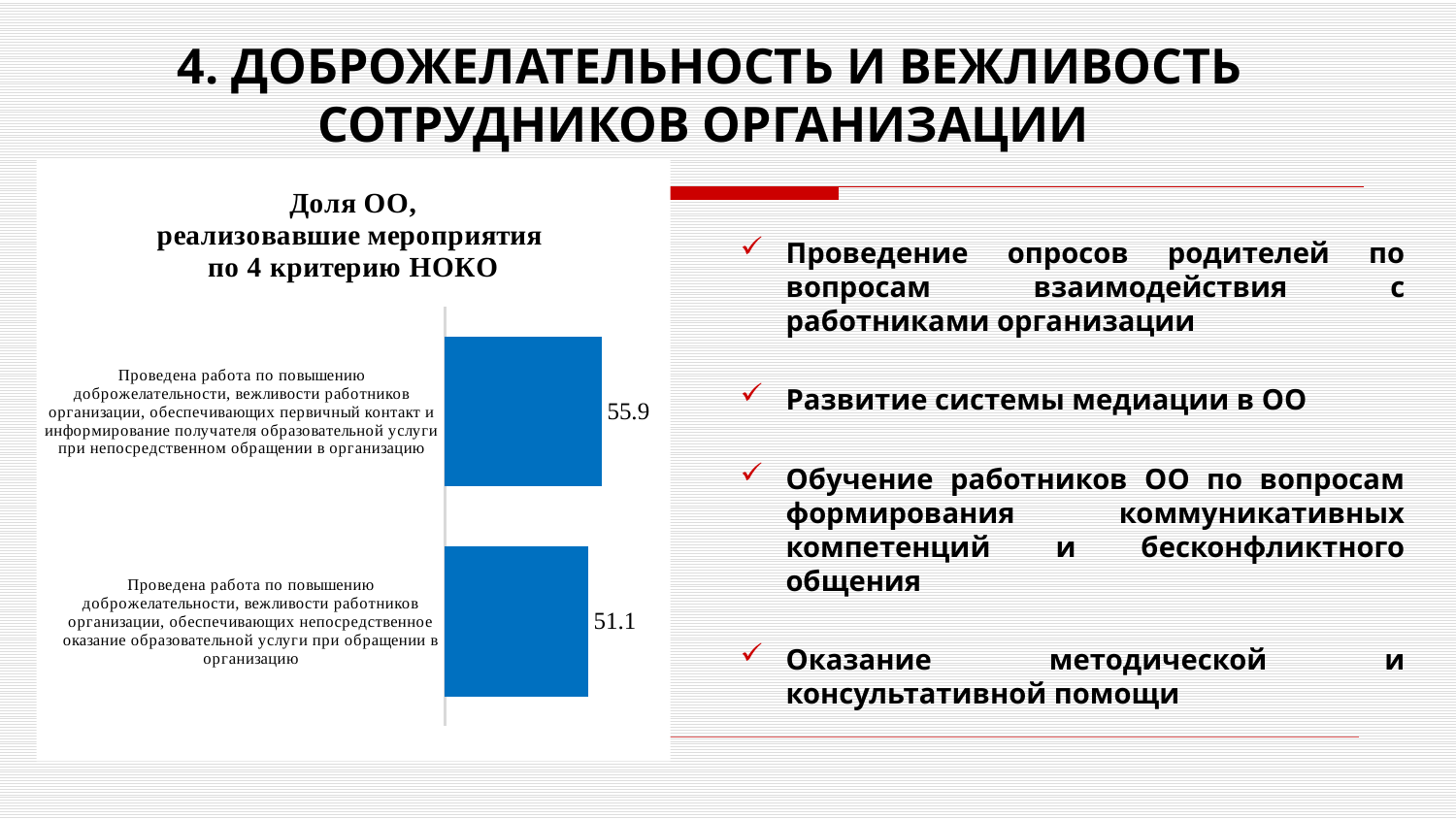
What is the value for the category about employees providing first contact and informing the recipient of the educational service (the top bar)? 55.9 What kind of chart is shown on the slide? Bar chart What is the value for the category about employees directly providing the educational service (the bottom bar)? 51.1 Which category has the lowest value? Проведена работа по повышению доброжелательности, вежливости работников организации, обеспечивающих непосредственное оказание образовательной услуги при обращении в организацию How many categories are shown in the chart? 2 What is the difference between the top bar (55.9) and the bottom bar (51.1)? 4.8 What colour are the bars in the chart? Blue Which is larger: the value for the top bar or the value for the bottom bar? The top bar (55.9) Are the bars in the chart horizontal or vertical? Horizontal What is the title of the chart? Доля ОО, реализовавшие мероприятия по 4 критерию НОКО